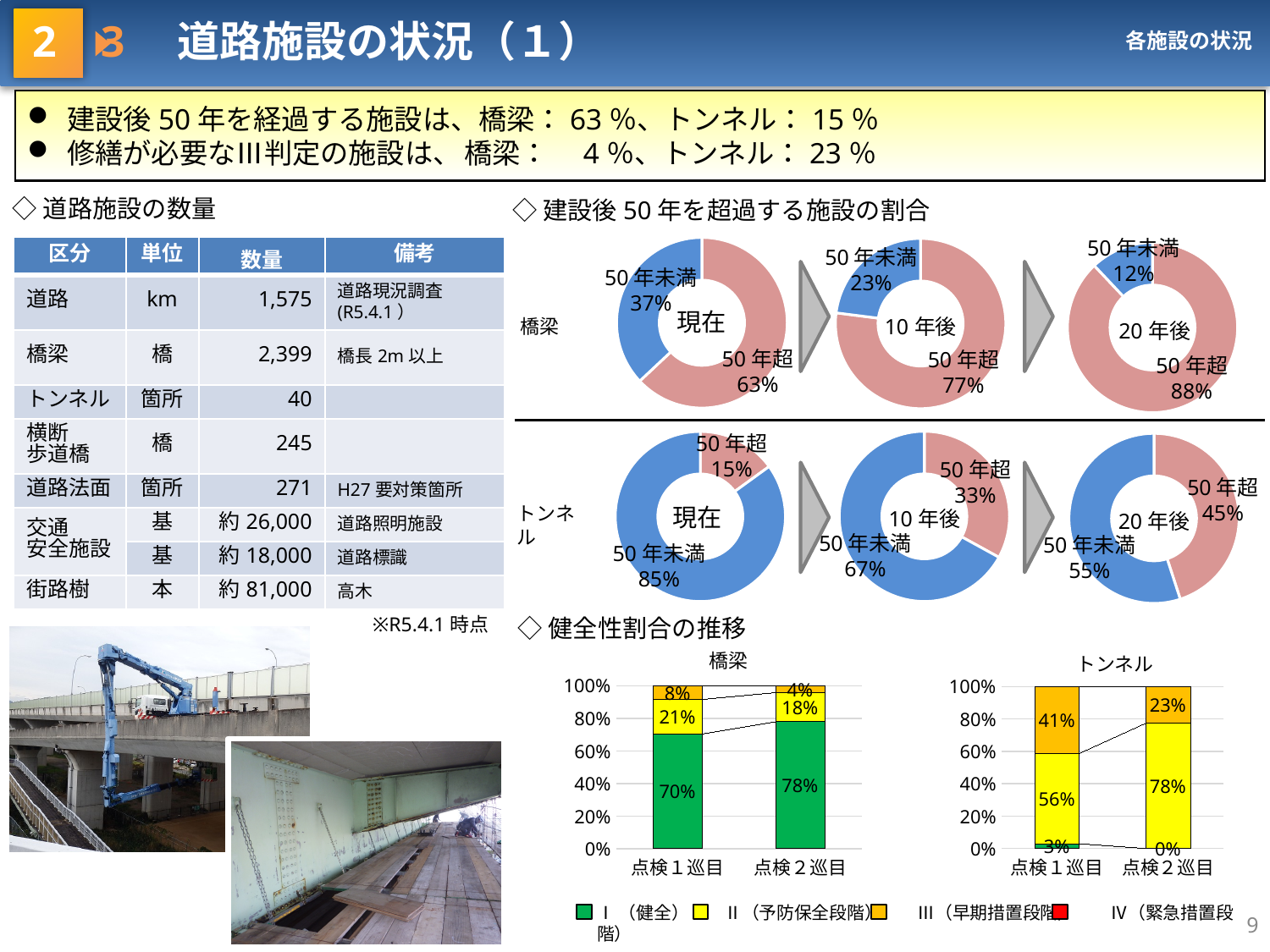
In the 橋梁 健全性割合の推移 chart, what is the value of the I (健全) segment for 点検2巡目? 78% In the 橋梁 20年後 donut chart, what share is labelled 50年未満? 12% How many entries does the legend below the 健全性割合の推移 charts list? 4 Across the three 橋梁 donut charts (現在, 10年後, 20年後), does the 50年超 share rise or fall over time? rise In the トンネル 現在 donut chart, what share is labelled 50年超? 15% In the 橋梁 現在 donut chart under 建設後50年を超過する施設の割合, what share is labelled 50年超? 63% In the トンネル 健全性割合の推移 chart, what is the value of the II (予防保全段階) segment for 点検1巡目? 56% In the 橋梁 健全性割合の推移 chart, what is the value of the III (早期措置段階) segment for 点検1巡目? 8% In the トンネル donut charts, by how many percentage points does the 50年超 share increase from 現在 to 10年後? 18 percentage points What kind of chart is the 橋梁 健全性割合の推移 chart? Stacked bar chart In the トンネル 健全性割合の推移 chart, which inspection round has the larger III (早期措置段階) share, 点検1巡目 or 点検2巡目? 点検1巡目 In the トンネル 20年後 donut chart, what share is labelled 50年未満? 55%